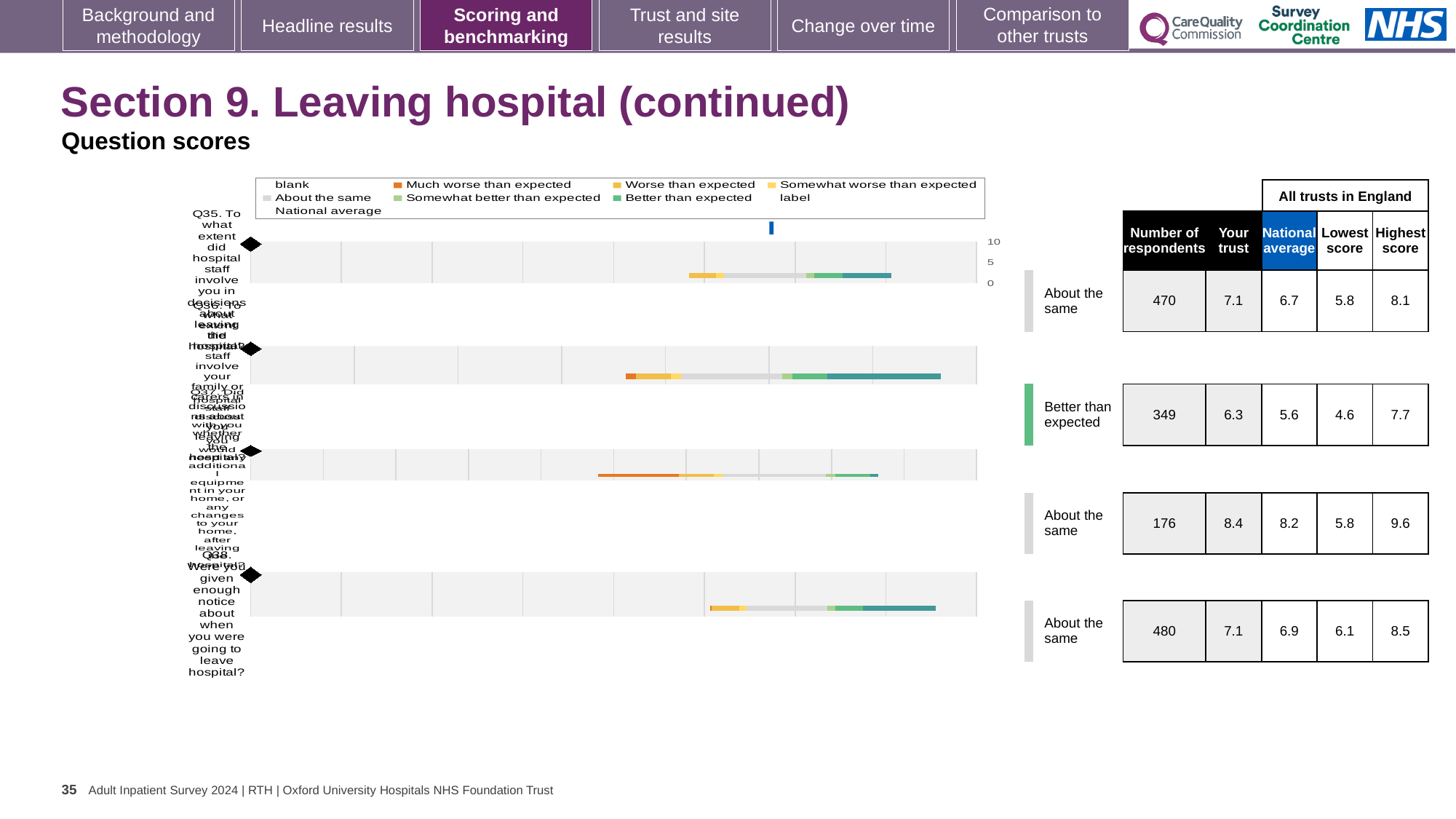
What is the difference between the 'Your trust' score and the national average for Q35? 0.4 How many question bars are plotted in the chart area on this slide? 4 What is the highest score across all trusts in England shown for Q35? 8.1 How many respondents are shown for Q38 (Were you given enough notice about when you were going to leave hospital?)? 480 What is the 'Your trust' score shown for Q35 (To what extent did hospital staff involve you in decisions about leaving hospital?)? 7.1 For Q38, is the 'Your trust' score larger or smaller than the national average? larger Which legend entry is shown in dark orange in the chart legend? Much worse than expected Which legend entry is shown in dark green in the chart legend? Better than expected How many of the four questions on this slide are rated 'Better than expected'? 1 What is the 'Your trust' score shown for Q38 (Were you given enough notice about when you were going to leave hospital?)? 7.1 What is the national average shown for Q38 (Were you given enough notice about when you were going to leave hospital?)? 6.9 What kind of chart is used to show the question scores on this slide? bar chart